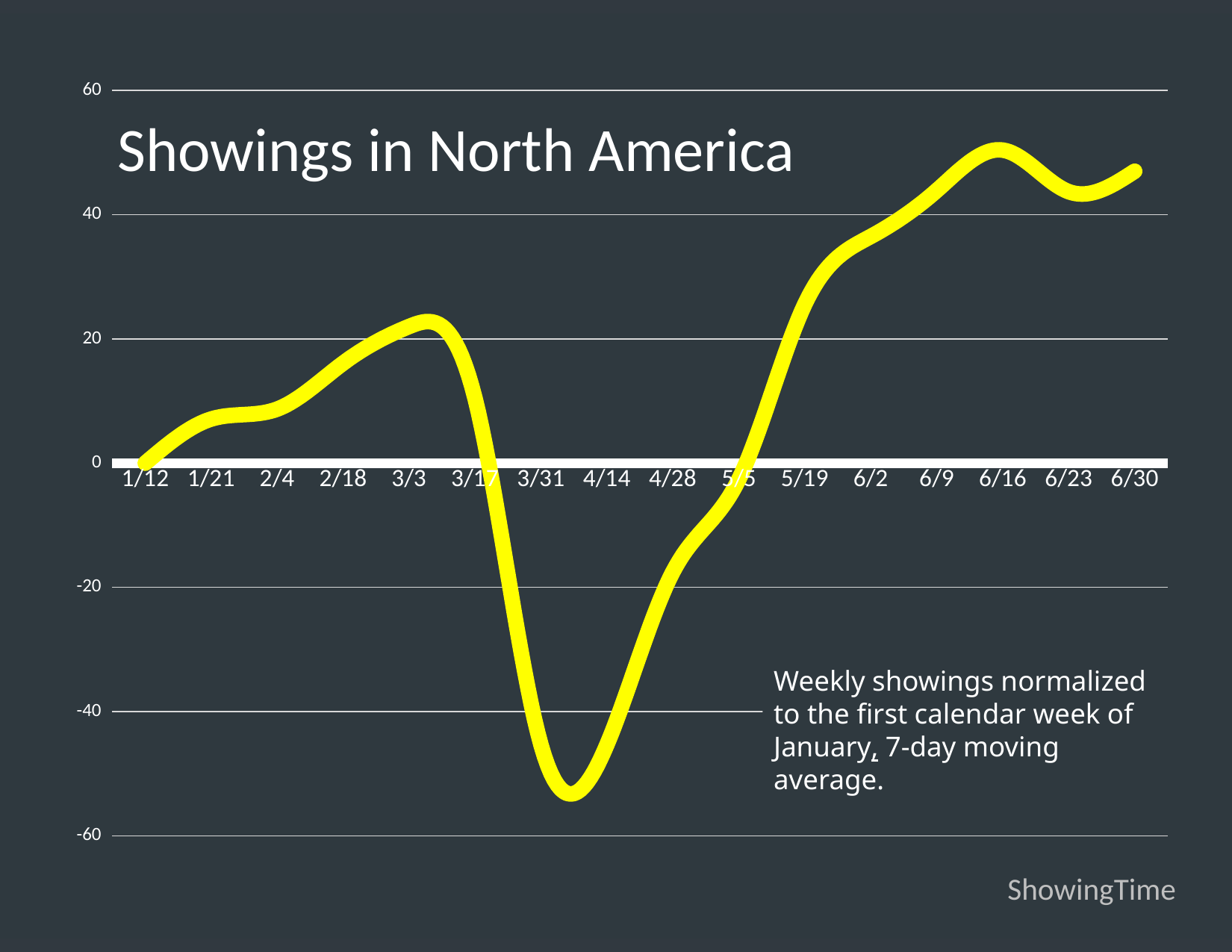
Is the value for 2/4 greater or less than 20? less Does the line rise or fall between 3/3 and 4/14? fall What is the title of the chart? Showings in North America Is the value for 6/2 greater or less than 20? greater Is the value for 6/16 greater or less than 40? greater Between which two labeled dates does the line reach its lowest point? 3/31 and 4/14 What kind of chart is shown on the slide? line chart How many dates are labeled on the x axis? 16 Which has the larger value, 6/9 or 4/28? 6/9 Near which labeled date does the line reach its highest point? 6/16